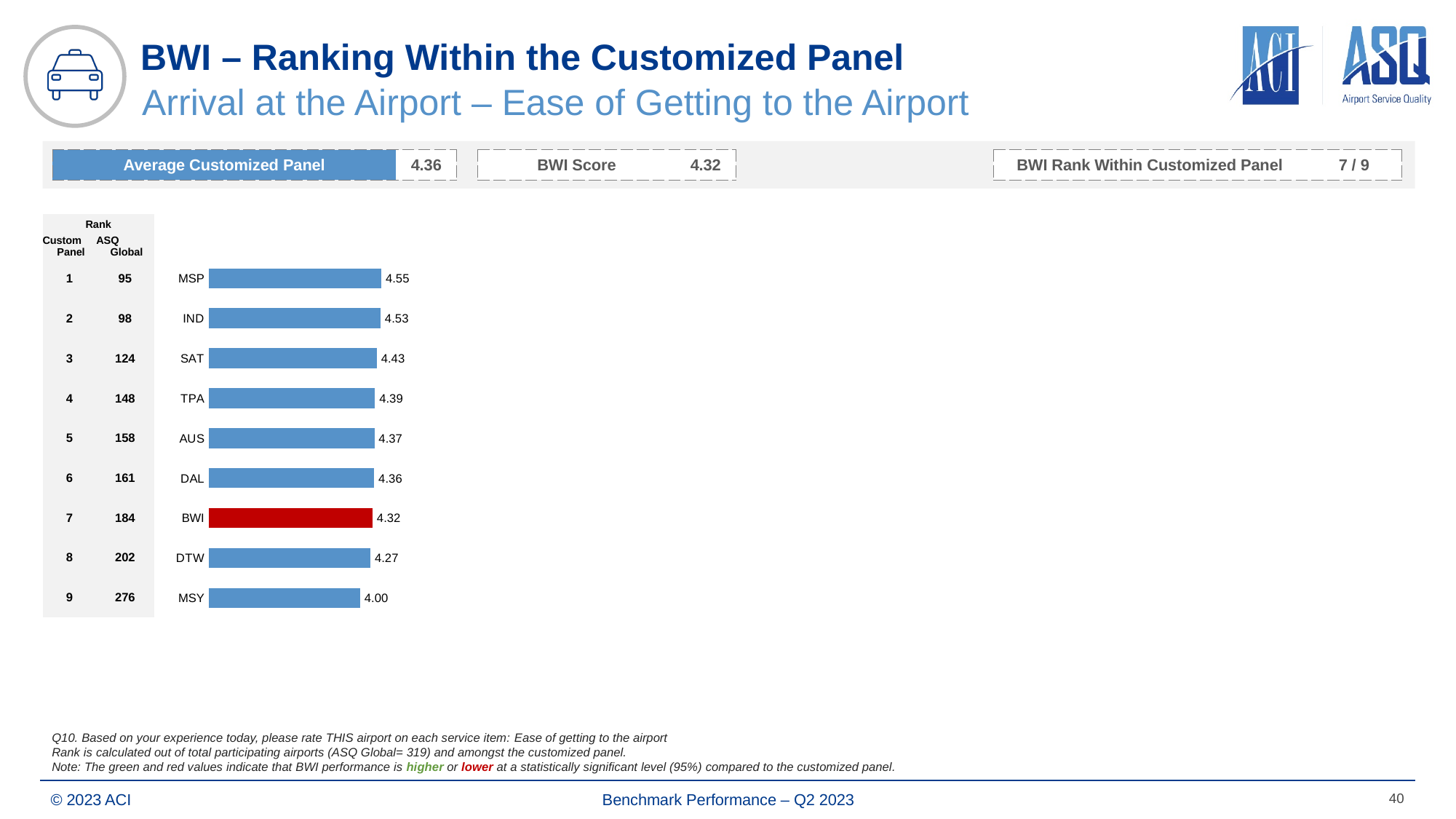
Which has a higher score, SAT or DAL? SAT How many airports are shown in the chart? 9 What is the score for TPA? 4.39 What is the difference between the scores for DTW and MSY? 0.27 Which airport has the highest score? MSP Which airport's bar is coloured red? BWI What is the score for MSY? 4.00 What is the score for BWI? 4.32 What is the score for MSP? 4.55 Which airport has the lowest score? MSY What is the difference between the scores for MSP and BWI? 0.23 What type of chart is shown on the slide? Bar chart